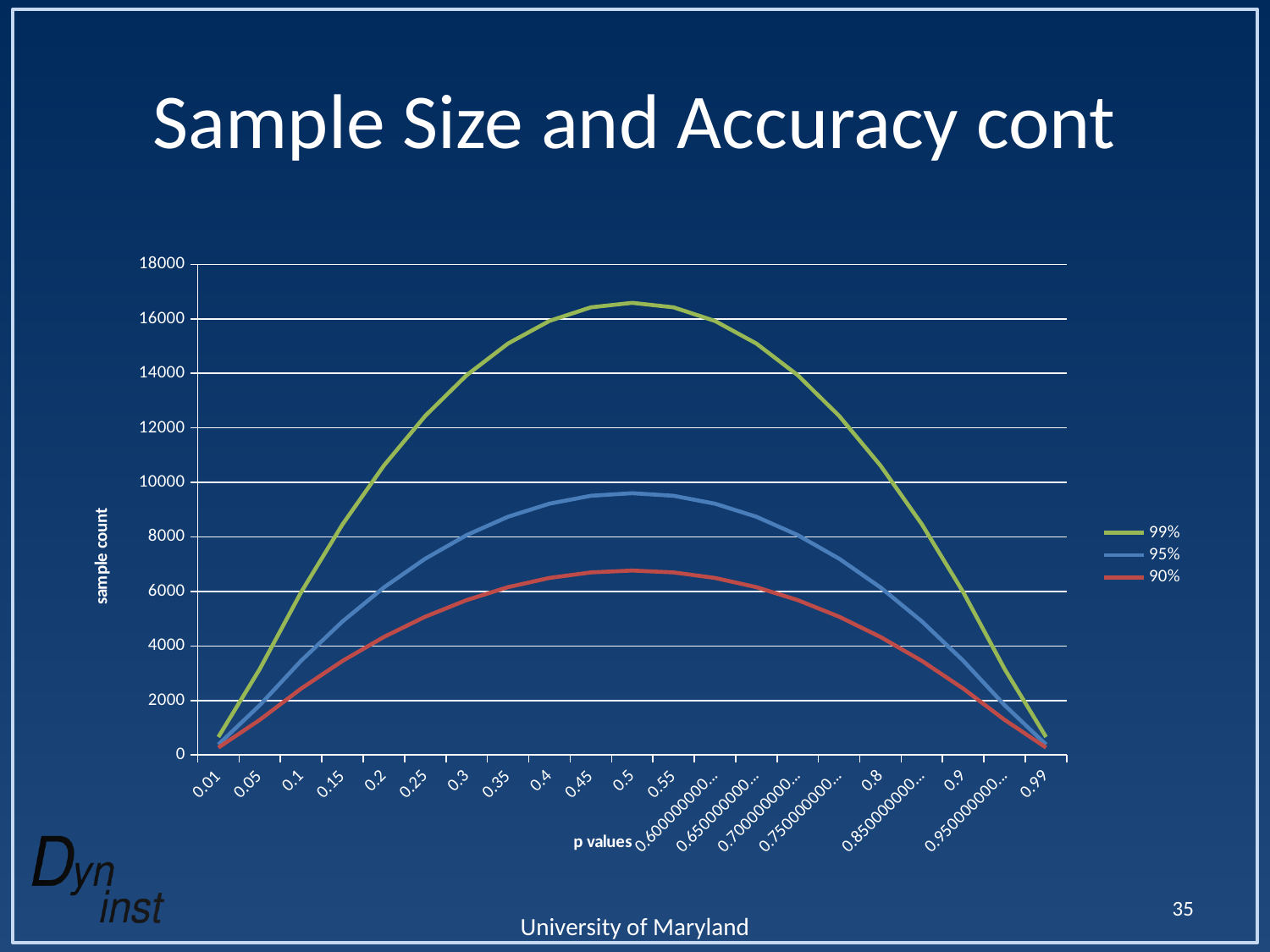
Which is larger at p value 0.8: the 95% series or the 90% series? 95% Which series has the lowest sample count at p value 0.5? 90% Is the value of the 99% series at p value 0.5 greater or less than 16000? greater Is the value of the 90% series at p value 0.5 greater or less than 6000? greater How many series does the legend list? 3 Is the value of the 95% series at p value 0.5 greater or less than 8000? greater What is the label of the vertical axis? sample count Which series has the highest sample count at p value 0.5? 99% At which p value does the 99% series reach its peak? 0.5 What kind of chart is shown on the slide? line chart